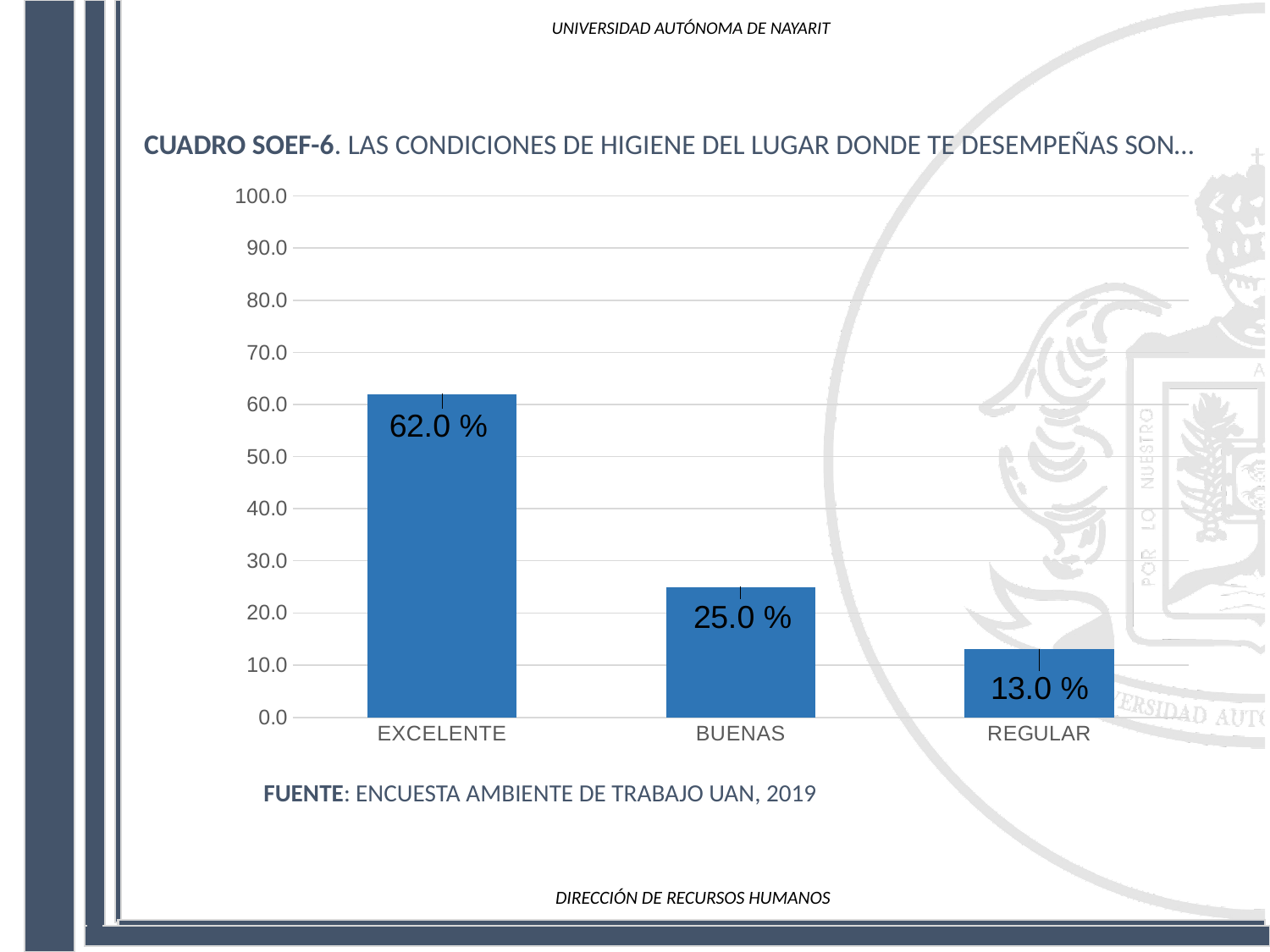
What is the value for REGULAR? 13.0 % What is the difference between the values for BUENAS and REGULAR? 12.0 % What is the difference between the values for EXCELENTE and BUENAS? 37.0 % What is the value for EXCELENTE? 62.0 % Is the value for EXCELENTE greater or less than 50.0? greater What is the value for BUENAS? 25.0 % Which category has the lowest value? REGULAR Which is larger, the value for BUENAS or the value for REGULAR? BUENAS Which category has the highest value? EXCELENTE Do the values rise or fall from left to right along the x axis? fall What kind of chart is shown on the slide? bar chart How many categories are shown on the x axis? 3